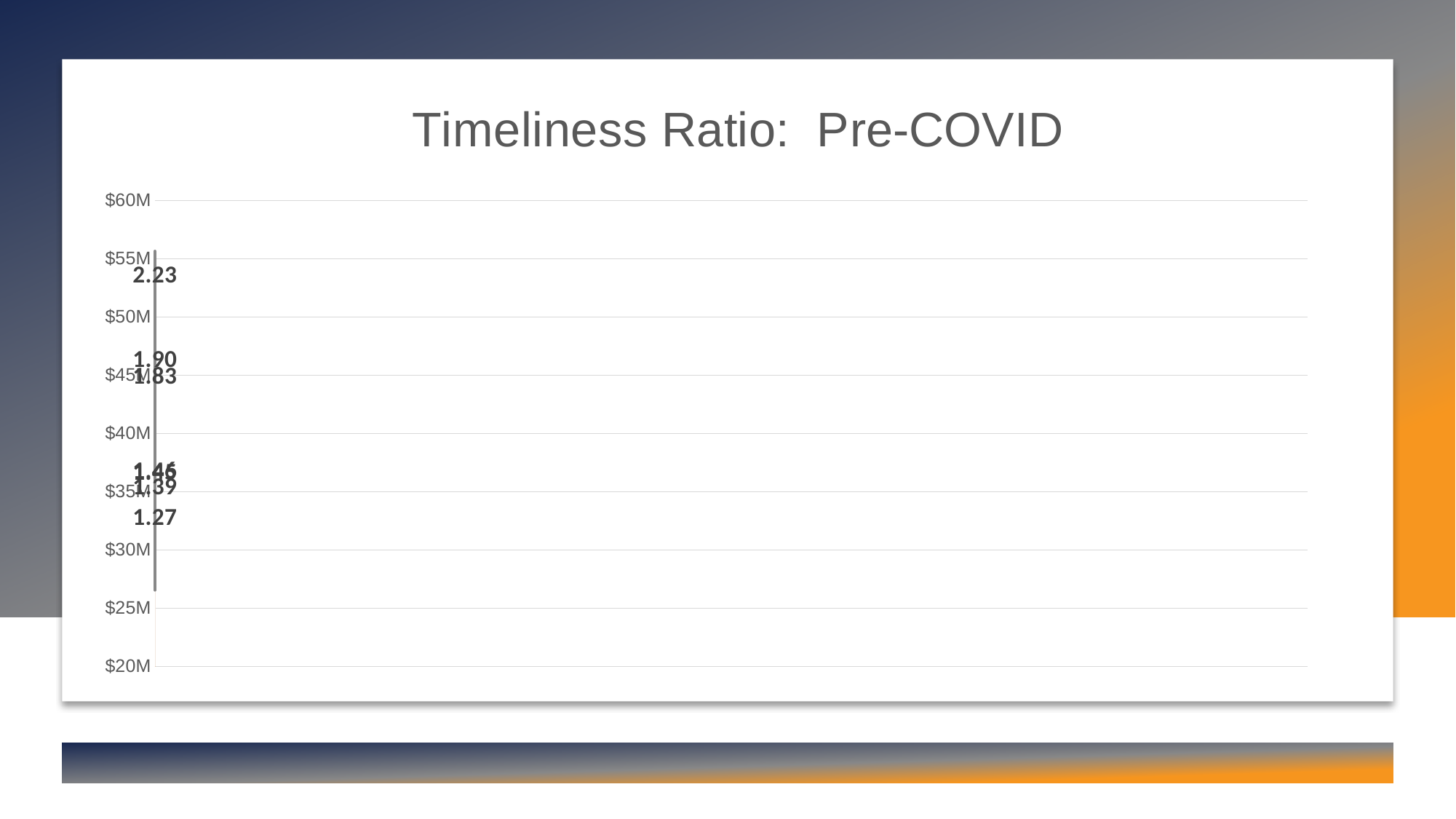
What is the largest data label value printed on the chart? 2.23 How many tick labels are shown on the vertical axis of the chart? 9 What is the highest value shown on the vertical axis of the chart? $60M What is the difference between the largest data label (2.23) and the smallest data label (1.27) on the chart? 0.96 What is the title of the chart? Timeliness Ratio: Pre-COVID Which data label is larger on the chart, 1.90 or 1.83? 1.90 What is the smallest data label value printed on the chart? 1.27